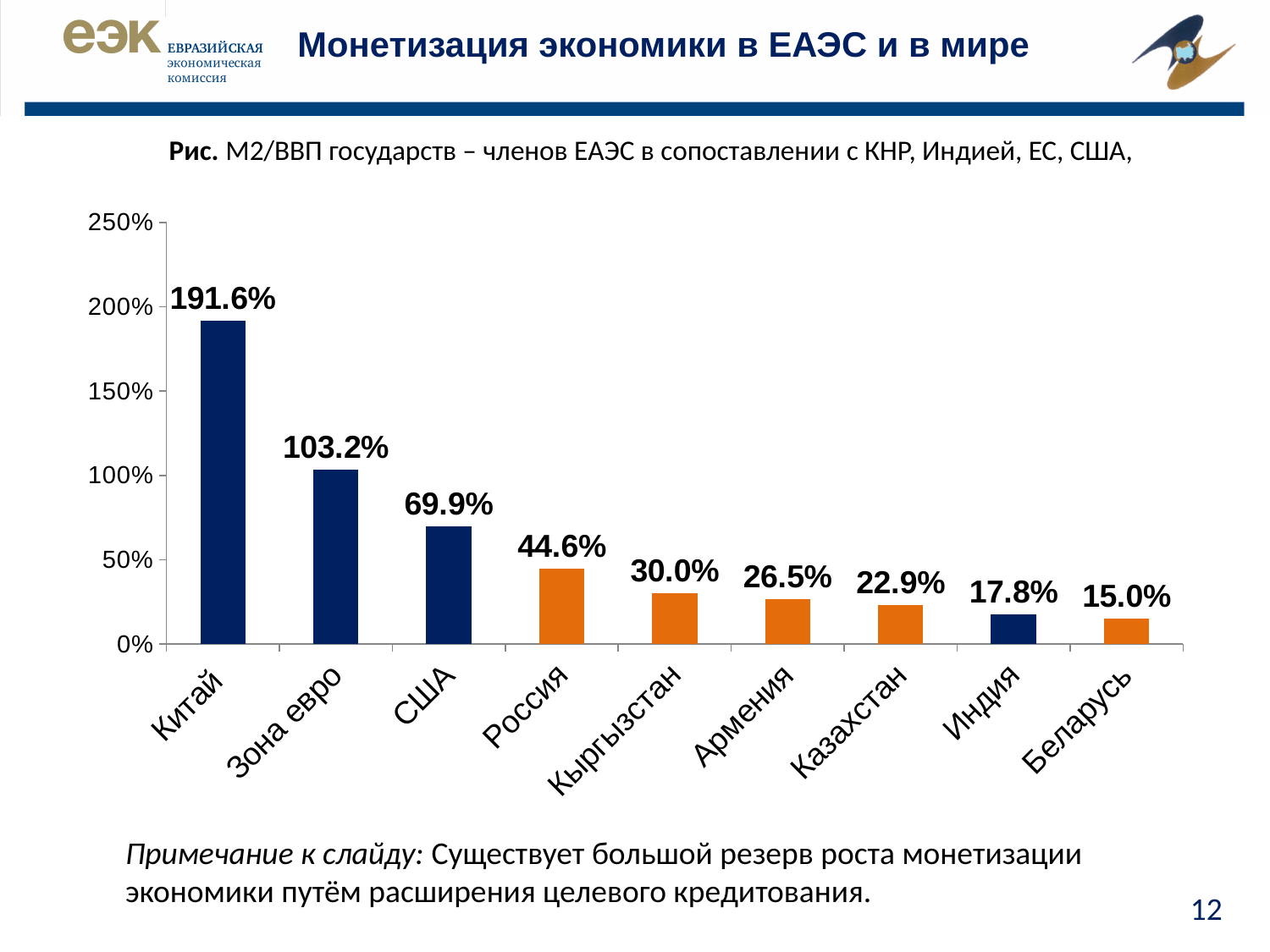
What kind of chart is shown on the slide? bar chart Do the values rise or fall moving from left to right along the x axis? fall How many categories are shown on the chart? 9 Which category has the lowest value on the chart? Беларусь Which category has the highest value on the chart? Китай What is the M2/GDP value shown for Китай? 191.6% Is the value for Зона евро greater or less than 100%? greater What value is shown for Россия? 44.6% What value is shown for Казахстан? 22.9% What is the difference between the values for Россия and Беларусь? 29.6% What is the difference between the values for Зона евро and США? 33.3% Which is larger, the value for Кыргызстан or the value for Армения? Кыргызстан